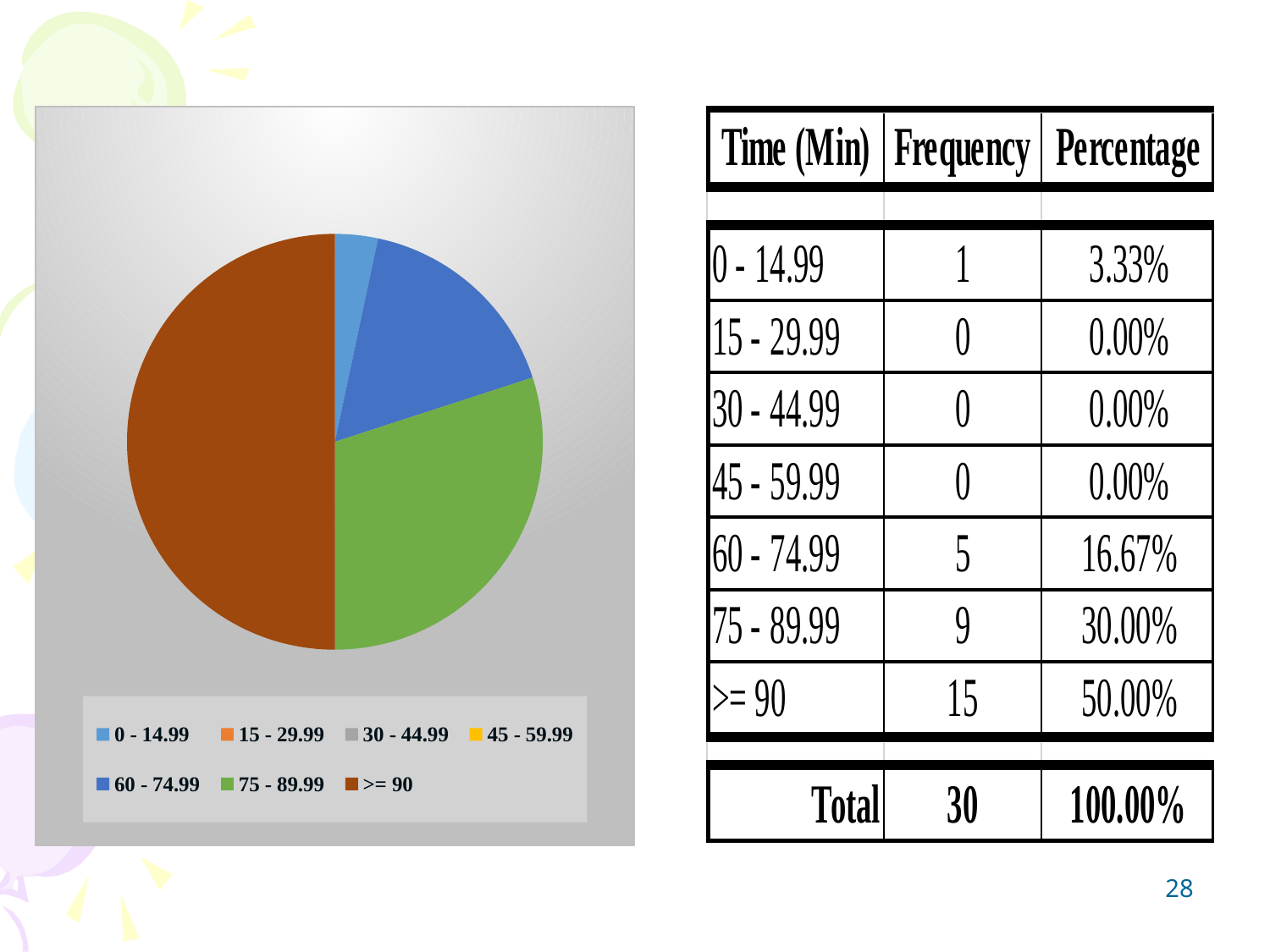
Which category has the largest slice of the pie chart? >= 90 What colour is the slice for the >= 90 category in the pie chart? brown According to the table on the slide, what is the total frequency across all categories? 30 According to the table on the slide, what share of the pie does the >= 90 slice represent? 50.00% How many categories does the pie chart's legend list? 7 Is the slice for 75 - 89.99 larger or smaller than the slice for 60 - 74.99? larger What kind of chart is shown on the slide? pie chart Is the slice for >= 90 larger or smaller than the slice for 75 - 89.99? larger According to the table on the slide, what share of the pie does the 75 - 89.99 slice represent? 30.00% According to the table on the slide, what is the frequency for the 60 - 74.99 category? 5 According to the table on the slide, what is the difference in frequency between the >= 90 and 75 - 89.99 categories? 6 Which of the visible slices is the smallest in the pie chart? 0 - 14.99